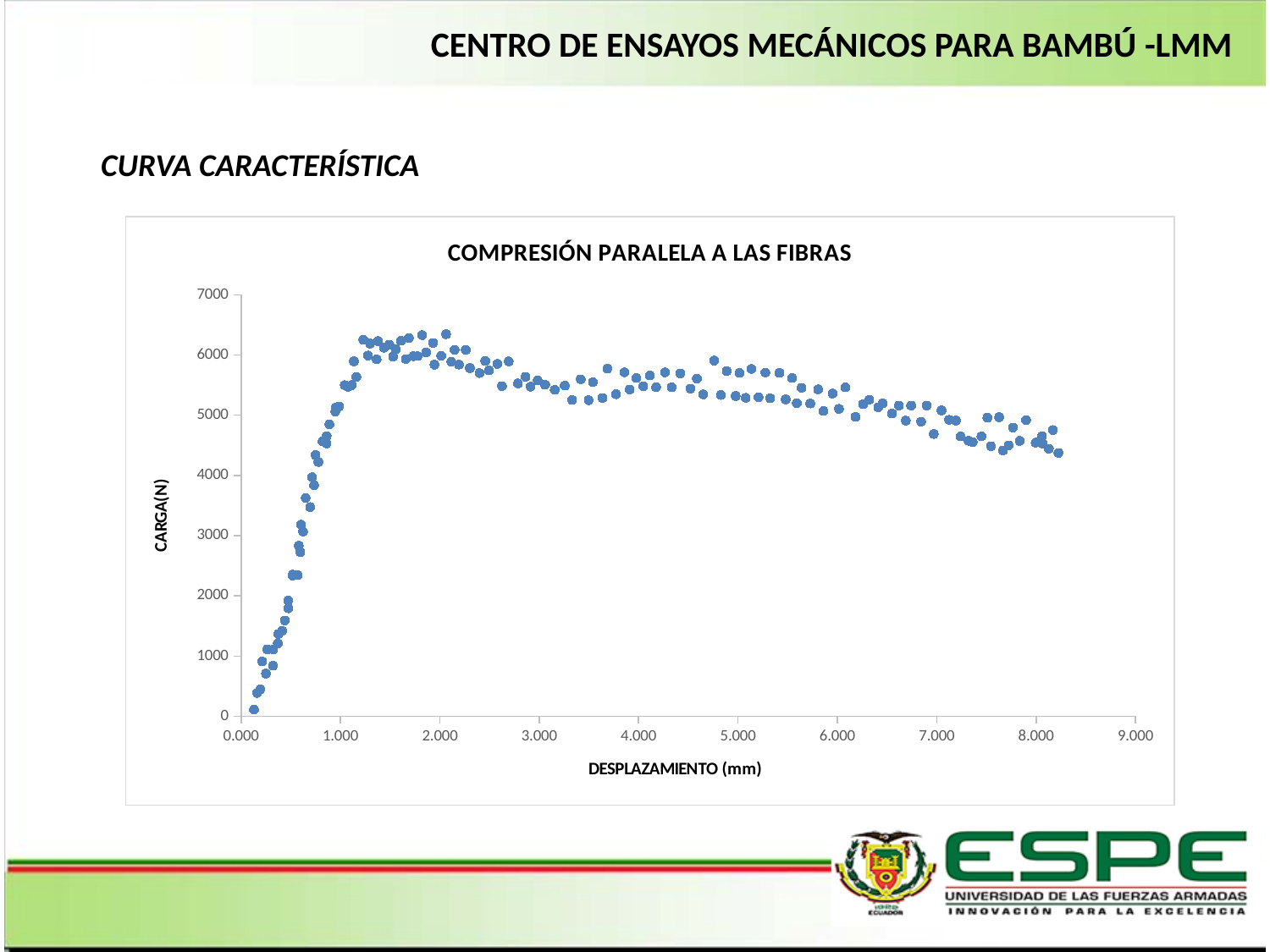
Between displacements of 5.000 mm and 8.000 mm, do the load values generally rise or fall? fall What is the title of the chart? COMPRESIÓN PARALELA A LAS FIBRAS Is the load (CARGA) at a displacement of about 3.000 mm greater or less than 5000? greater Which is larger: the load at a displacement of about 0.500 mm or the load at about 2.000 mm? about 2.000 mm Is the highest load reached in the chart greater or less than 6000? greater Is the load (CARGA) at a displacement of about 1.500 mm greater or less than 5000? greater Between displacements of 0.000 mm and 1.000 mm, do the load values rise or fall? rise What kind of chart is shown on the slide? Scatter chart What is the label of the vertical axis of the chart? CARGA(N)